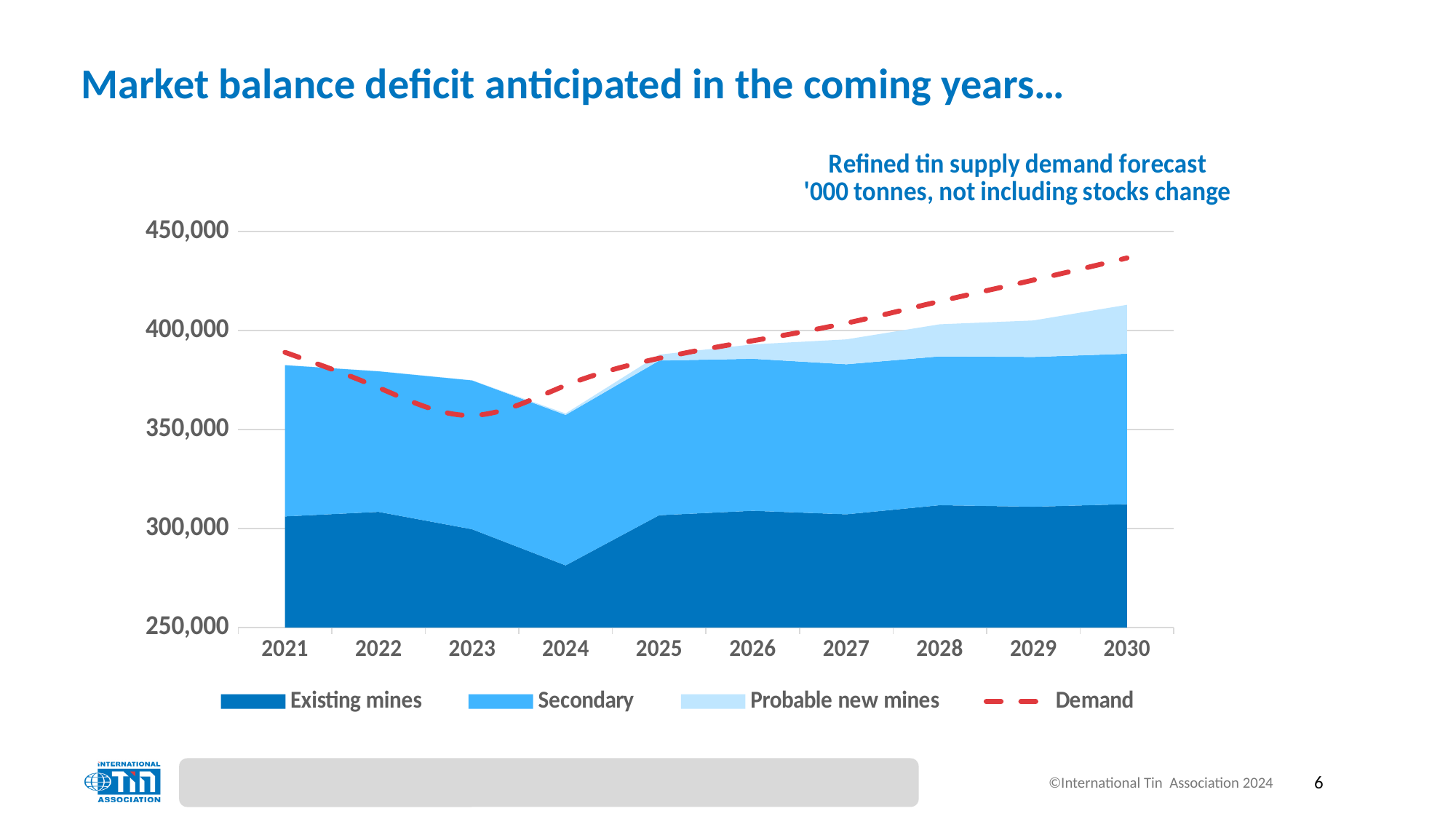
Which series is drawn as a red dashed line? Demand Is the value for Existing mines in 2024 greater or less than 300,000? less In which year is the Existing mines series at its lowest? 2024 In 2030, which is larger: Demand or total supply (all stacked areas)? Demand Does Demand rise or fall from 2024 to 2030? rise What is the title of the chart? Refined tin supply demand forecast '000 tonnes, not including stocks change What kind of chart is shown on the slide? Stacked area chart with a line How many years are shown on the x axis? 10 In which year is Demand at its highest? 2030 Is the Demand value in 2021 greater or less than 400,000? less Is the Demand value in 2030 greater or less than 400,000? greater How many series does the legend list? 4